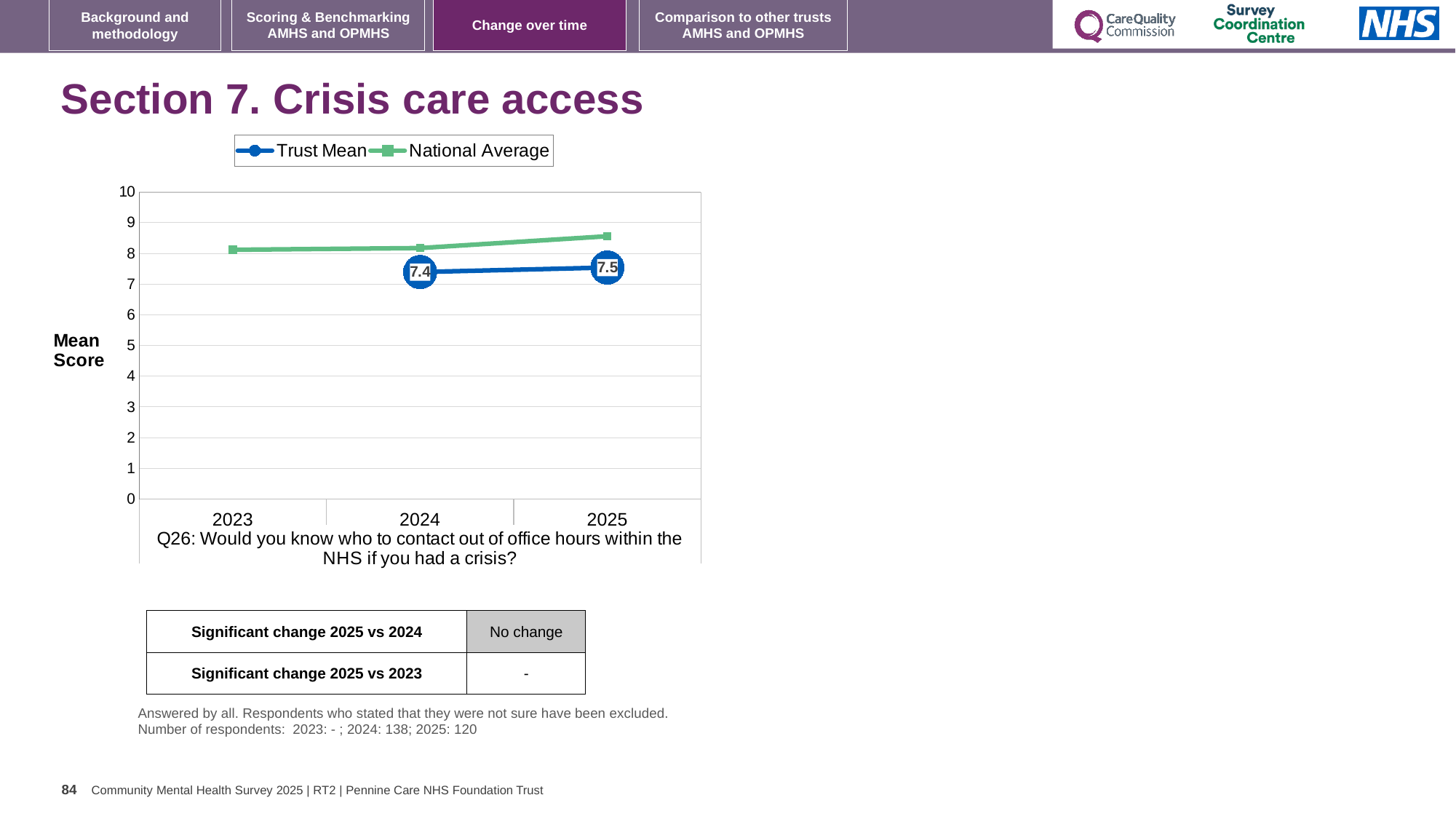
In 2025, which series is higher, Trust Mean or National Average? National Average How many years are shown on the x axis? 3 Does the Trust Mean rise or fall from 2024 to 2025? Rise Is the National Average value for 2025 greater or less than 8? greater What kind of chart is shown on the slide? Line chart What is the Trust Mean value for 2025? 7.5 What is the label on the y axis of the chart? Mean Score By how much did the Trust Mean change from 2024 to 2025? 0.1 Is the National Average value for 2023 greater or less than 9? less How many series does the legend list? 2 What is the Trust Mean value for 2024? 7.4 Which year has the higher Trust Mean, 2024 or 2025? 2025